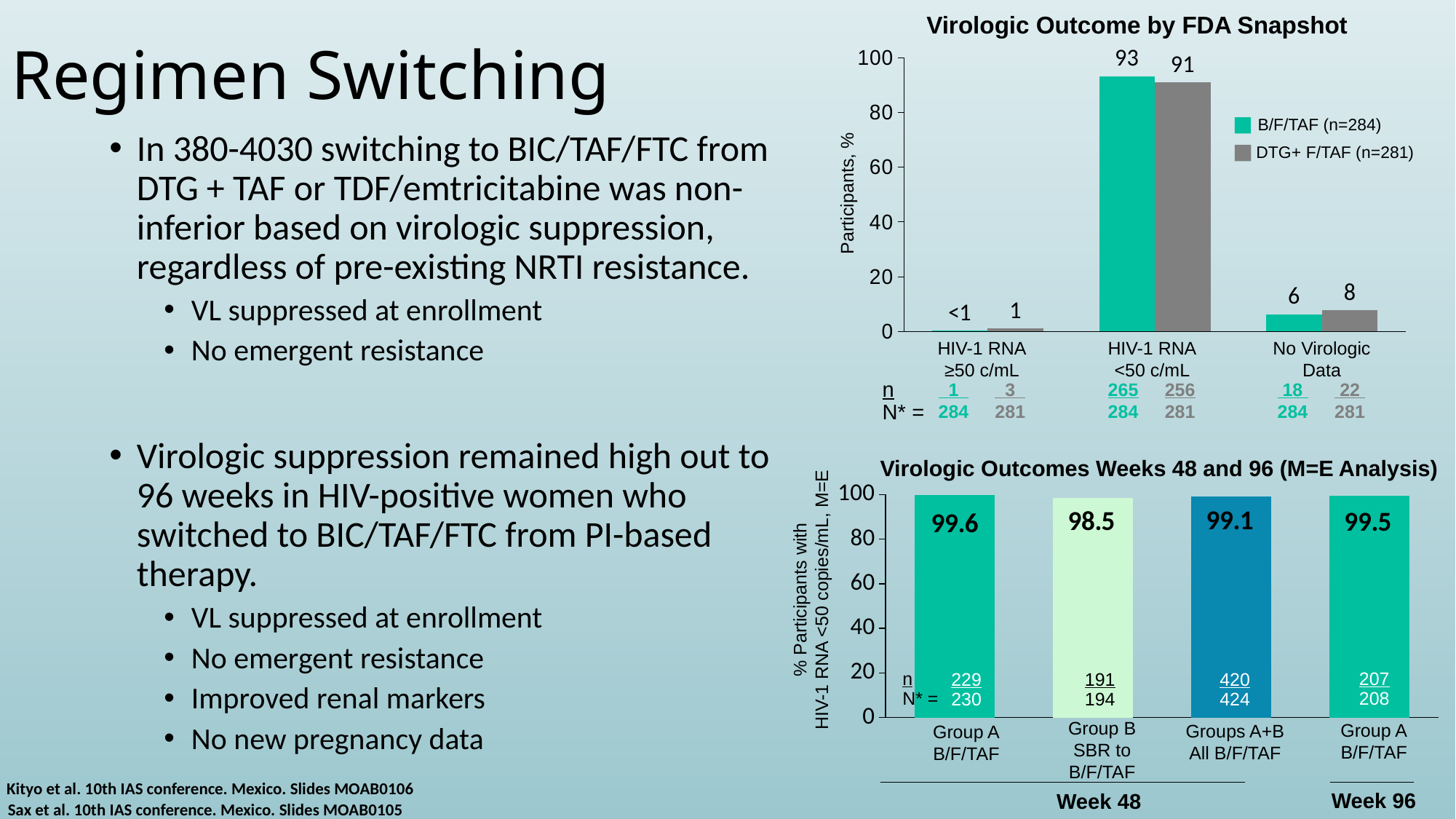
In the 'Virologic Outcomes Weeks 48 and 96 (M=E Analysis)' chart, what is the difference between the Group A B/F/TAF value at Week 48 and at Week 96? 0.1 In the 'Virologic Outcome by FDA Snapshot' chart, what percentage of B/F/TAF participants had HIV-1 RNA <50 c/mL? 93 In the 'Virologic Outcomes Weeks 48 and 96 (M=E Analysis)' chart, which bar has the lowest value? Group B SBR to B/F/TAF How many categories are shown on the x axis of the 'Virologic Outcome by FDA Snapshot' chart? 3 In the 'Virologic Outcomes Weeks 48 and 96 (M=E Analysis)' chart, which bar has the highest value? Group A B/F/TAF (Week 48) In the 'Virologic Outcomes Weeks 48 and 96 (M=E Analysis)' chart, what is the n/N* shown for Groups A+B All B/F/TAF? 420/424 What type of chart is the 'Virologic Outcome by FDA Snapshot' chart? Bar chart In the 'Virologic Outcome by FDA Snapshot' chart, which group has the higher value for No Virologic Data, B/F/TAF or DTG+ F/TAF? DTG+ F/TAF In the 'Virologic Outcomes Weeks 48 and 96 (M=E Analysis)' chart, what is the value for Group B SBR to B/F/TAF at Week 48? 98.5 How many series does the legend of the 'Virologic Outcome by FDA Snapshot' chart list? 2 In the 'Virologic Outcome by FDA Snapshot' chart, what is the difference between the B/F/TAF and DTG+ F/TAF values for HIV-1 RNA <50 c/mL? 2 In the 'Virologic Outcome by FDA Snapshot' chart, what percentage of DTG+ F/TAF participants had No Virologic Data? 8